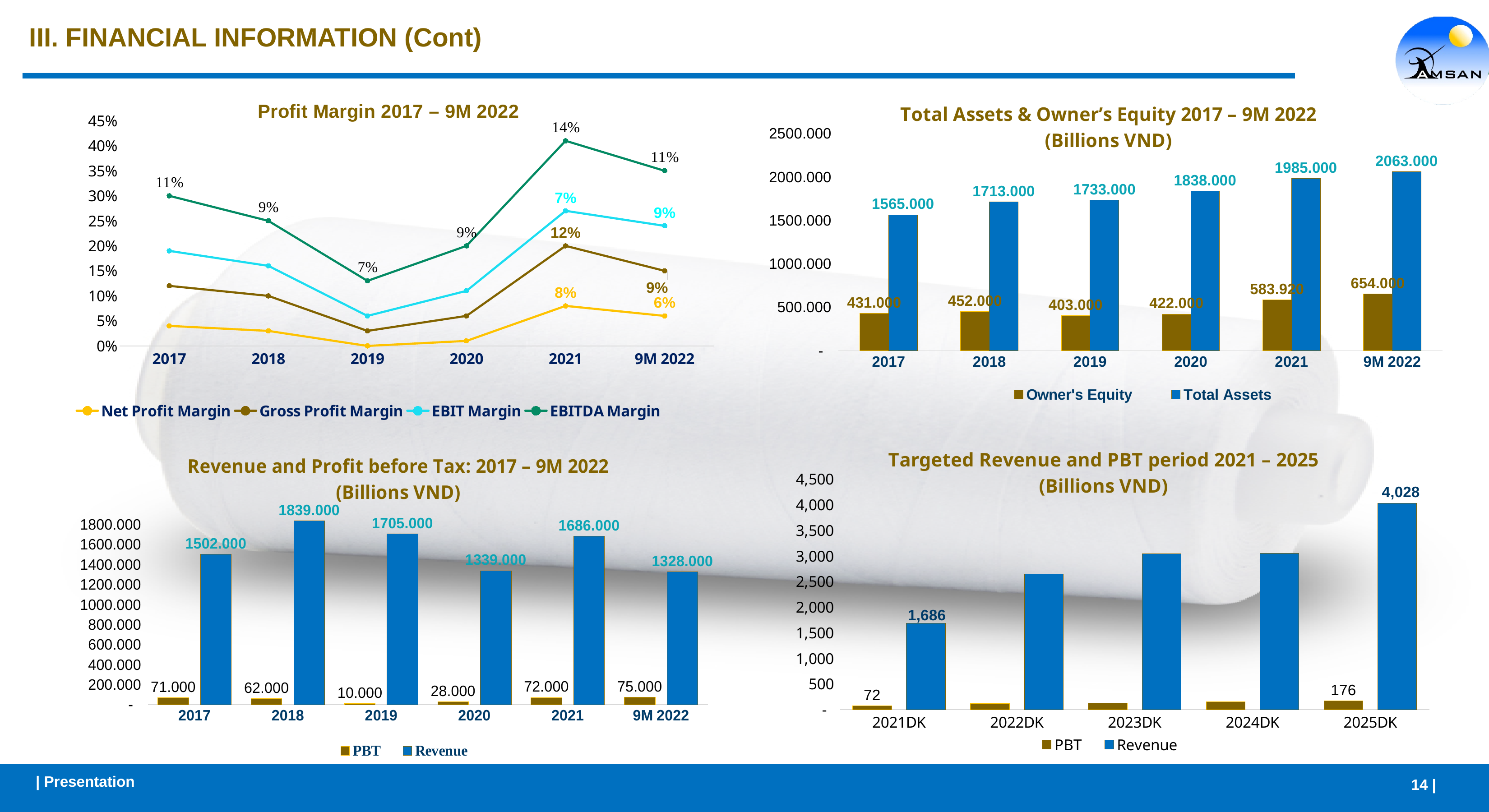
In the 'Targeted Revenue and PBT period 2021 – 2025' chart, is the Revenue for 2022DK greater or less than 2,500? greater In the 'Total Assets & Owner's Equity 2017 – 9M 2022' chart, what is the Total Assets value for 2020? 1838.000 In the 'Targeted Revenue and PBT period 2021 – 2025' chart, what is the Revenue value for 2025DK? 4,028 In the 'Total Assets & Owner's Equity 2017 – 9M 2022' chart, which year has the lowest Owner's Equity? 2019 In the 'Revenue and Profit before Tax: 2017 – 9M 2022' chart, which year has the lowest PBT? 2019 In the 'Profit Margin 2017 – 9M 2022' chart, what is the data label for EBITDA Margin in 2021? 14% In the 'Targeted Revenue and PBT period 2021 – 2025' chart, how many categories are shown on the x axis? 5 In the 'Revenue and Profit before Tax: 2017 – 9M 2022' chart, is Revenue higher in 2019 or in 2021? 2019 How many series does the legend of the 'Profit Margin 2017 – 9M 2022' chart list? 4 In the 'Total Assets & Owner's Equity 2017 – 9M 2022' chart, what is the difference between Total Assets and Owner's Equity in 9M 2022? 1409.000 In the 'Revenue and Profit before Tax: 2017 – 9M 2022' chart, what is the Revenue for 2018? 1839.000 What kind of chart is 'Profit Margin 2017 – 9M 2022'? Line chart